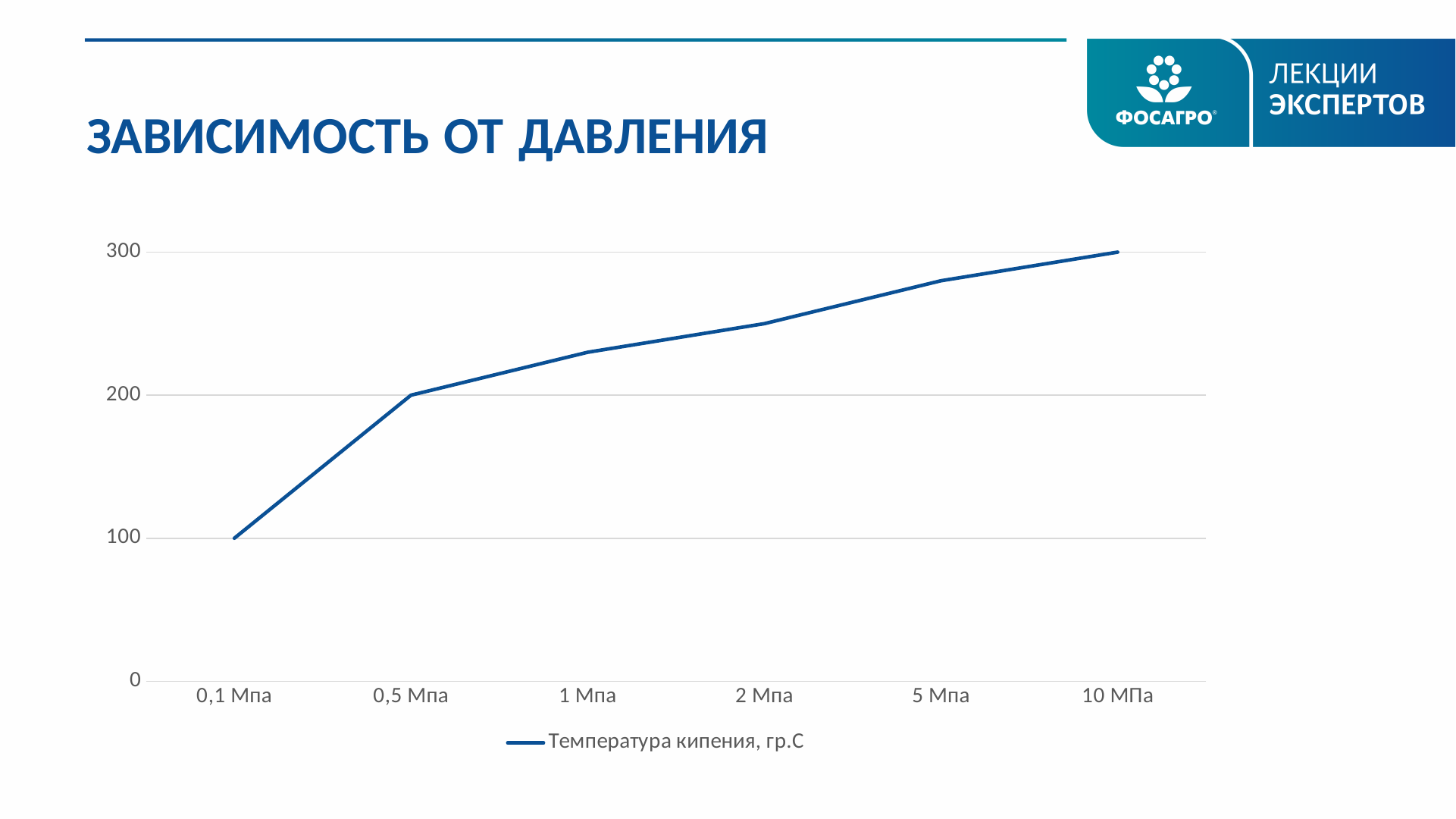
What is the boiling temperature value at 10 МПа? 300 What is the boiling temperature value at 0,1 Мпа? 100 Is the boiling temperature at 5 Мпа greater or less than 300? less What kind of chart is shown on the slide? line chart What is the boiling temperature value at 0,5 Мпа? 200 At which pressure is the boiling temperature lowest? 0,1 Мпа Do the values rise or fall as pressure increases along the x axis? rise At which pressure is the boiling temperature highest? 10 МПа Which is larger: the boiling temperature at 2 Мпа or at 0,5 Мпа? 2 Мпа How many pressure points are plotted on the x axis? 6 What is the difference between the boiling temperature at 10 МПа and at 0,1 Мпа? 200 Is the boiling temperature at 1 Мпа greater or less than 200? greater